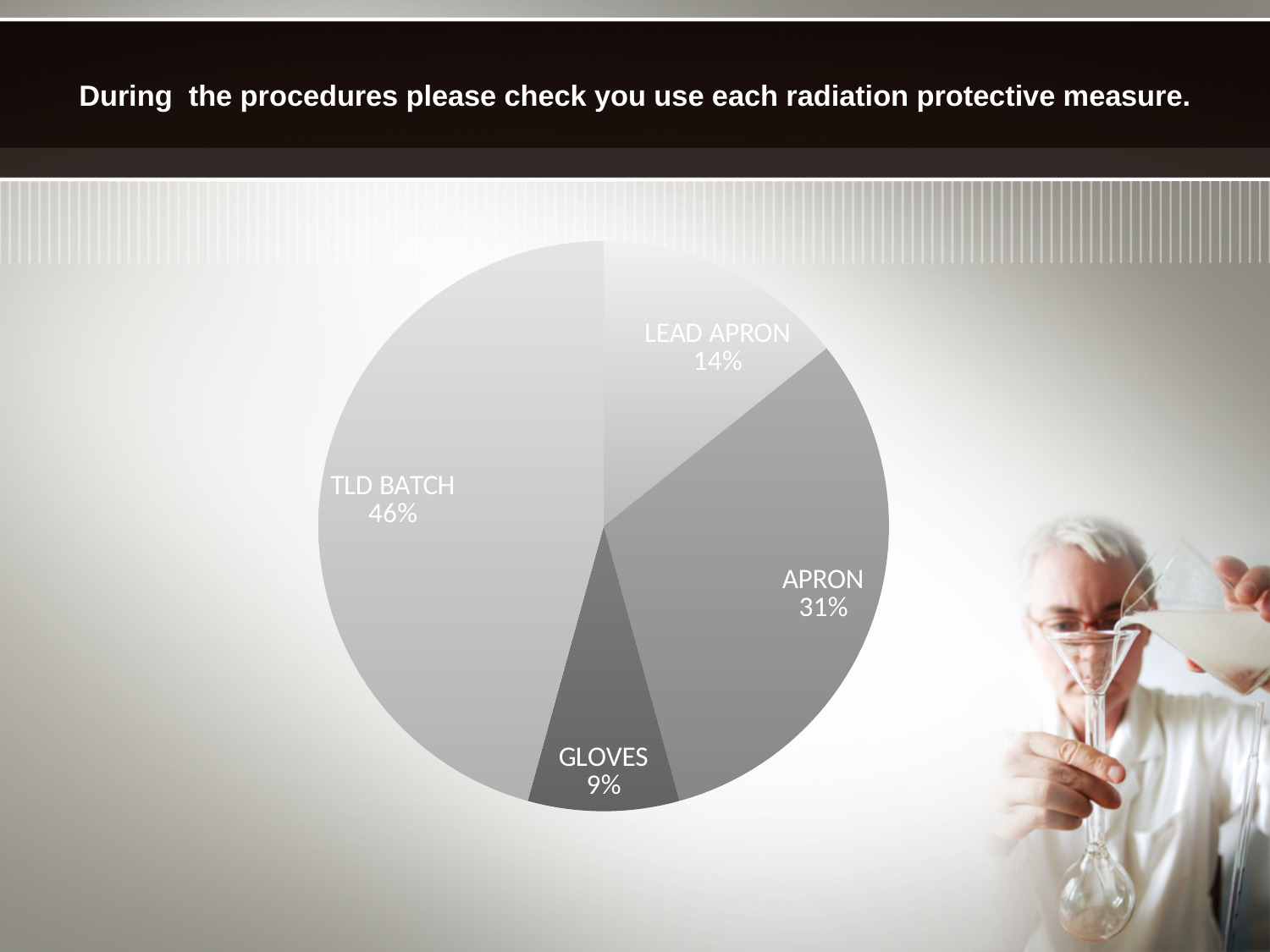
Which is larger, the share for APRON or the share for LEAD APRON? APRON What share of the pie does TLD BATCH have? 46% Which category has the smallest slice of the pie? GLOVES What is the difference in percentage points between TLD BATCH and APRON? 15 How many slices does the pie chart have? 4 What percentage is shown for GLOVES? 9% What kind of chart is shown on the slide? pie chart What percentage is shown for APRON? 31% What is the difference in percentage points between LEAD APRON and GLOVES? 5 Which category has the largest slice of the pie? TLD BATCH What percentage is shown for LEAD APRON? 14% What is the title text shown above the chart? During the procedures please check you use each radiation protective measure.